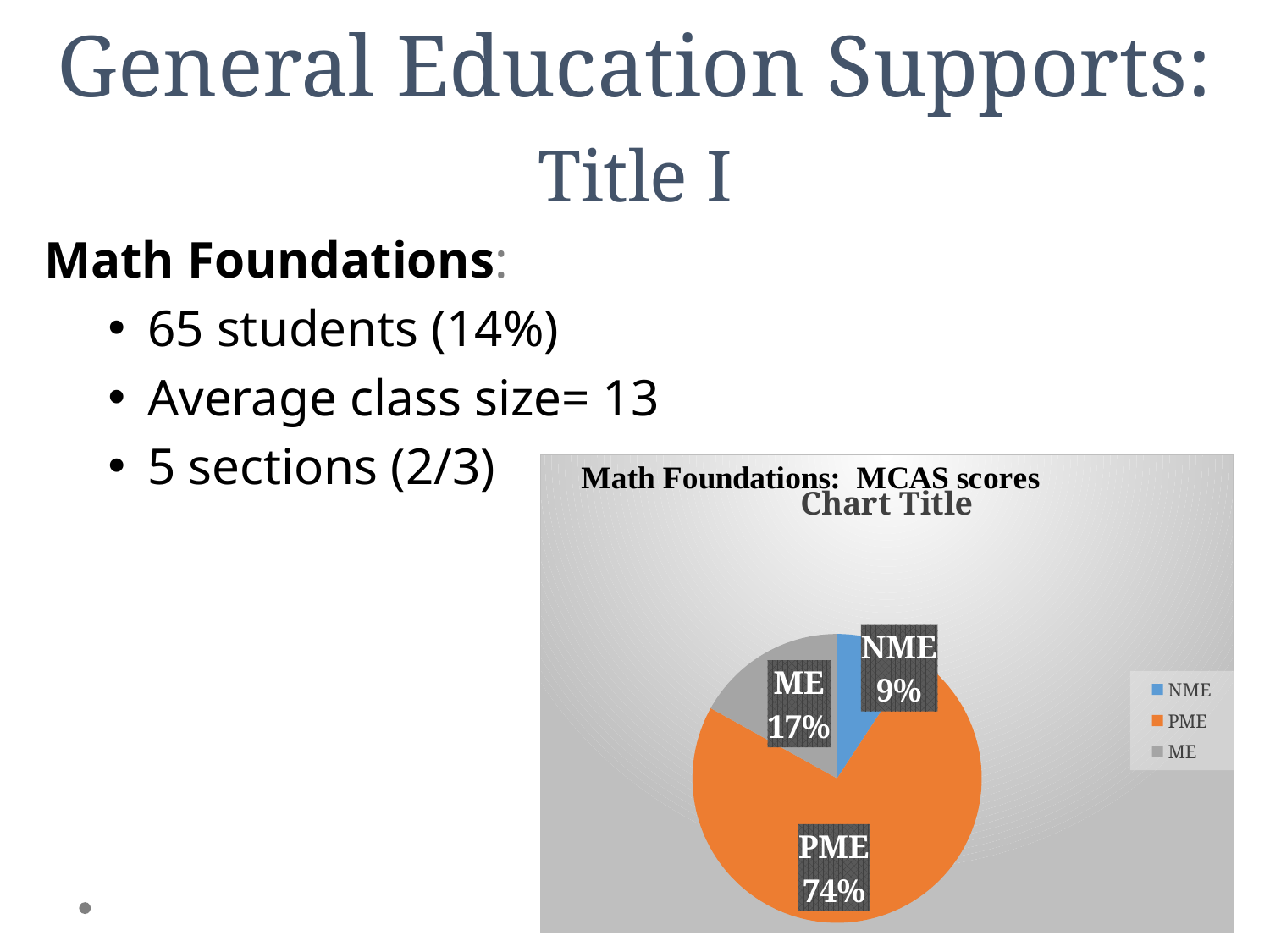
Which category has the largest share of the pie? PME Which is larger, the share for ME or the share for NME? ME What percentage of the pie is PME? 74% What is the difference in percentage points between PME and ME? 57 What percentage of the pie is ME? 17% What percentage of the pie is NME? 9% Which category has the smallest share of the pie? NME What is the difference in percentage points between ME and NME? 8 What colour is the PME slice? orange What kind of chart is shown on the slide? pie chart How many slices does the pie chart have? 3 How many entries does the legend list? 3